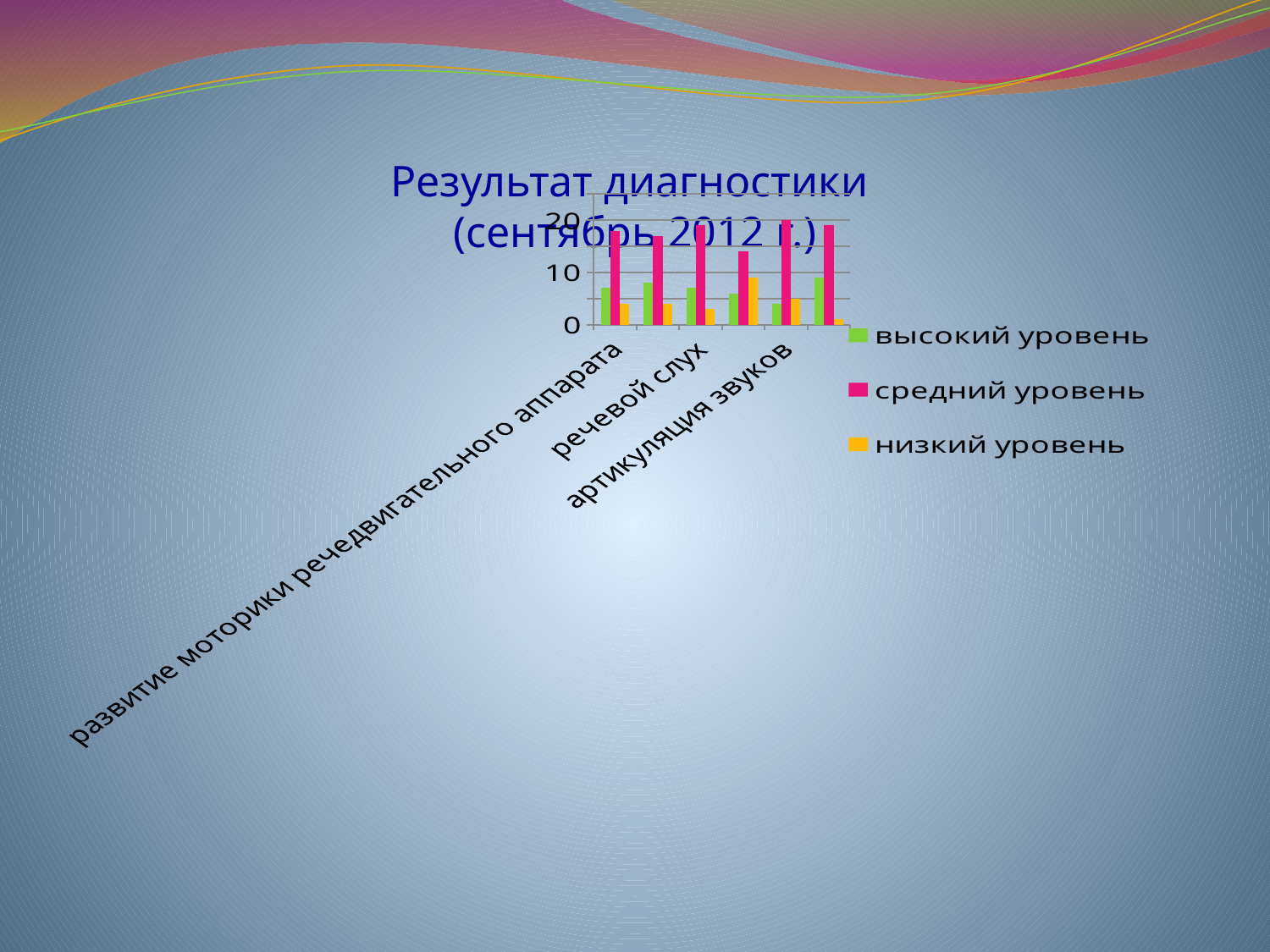
In the first group of bars, which is larger: средний уровень or высокий уровень? средний уровень Is the value for средний уровень in the first group of bars greater or less than 10? greater Which legend entry is shown in pink? средний уровень Which series has the tallest bar in the chart? средний уровень Is the value for высокий уровень in the first group of bars greater or less than 10? less How many series does the legend list? 3 In the last group of bars, which is larger: высокий уровень or низкий уровень? высокий уровень What kind of chart is shown on the slide? bar chart Is the value for низкий уровень in the first group of bars greater or less than 10? less What is the title of the chart? Результат диагностики (сентябрь 2012 г.)